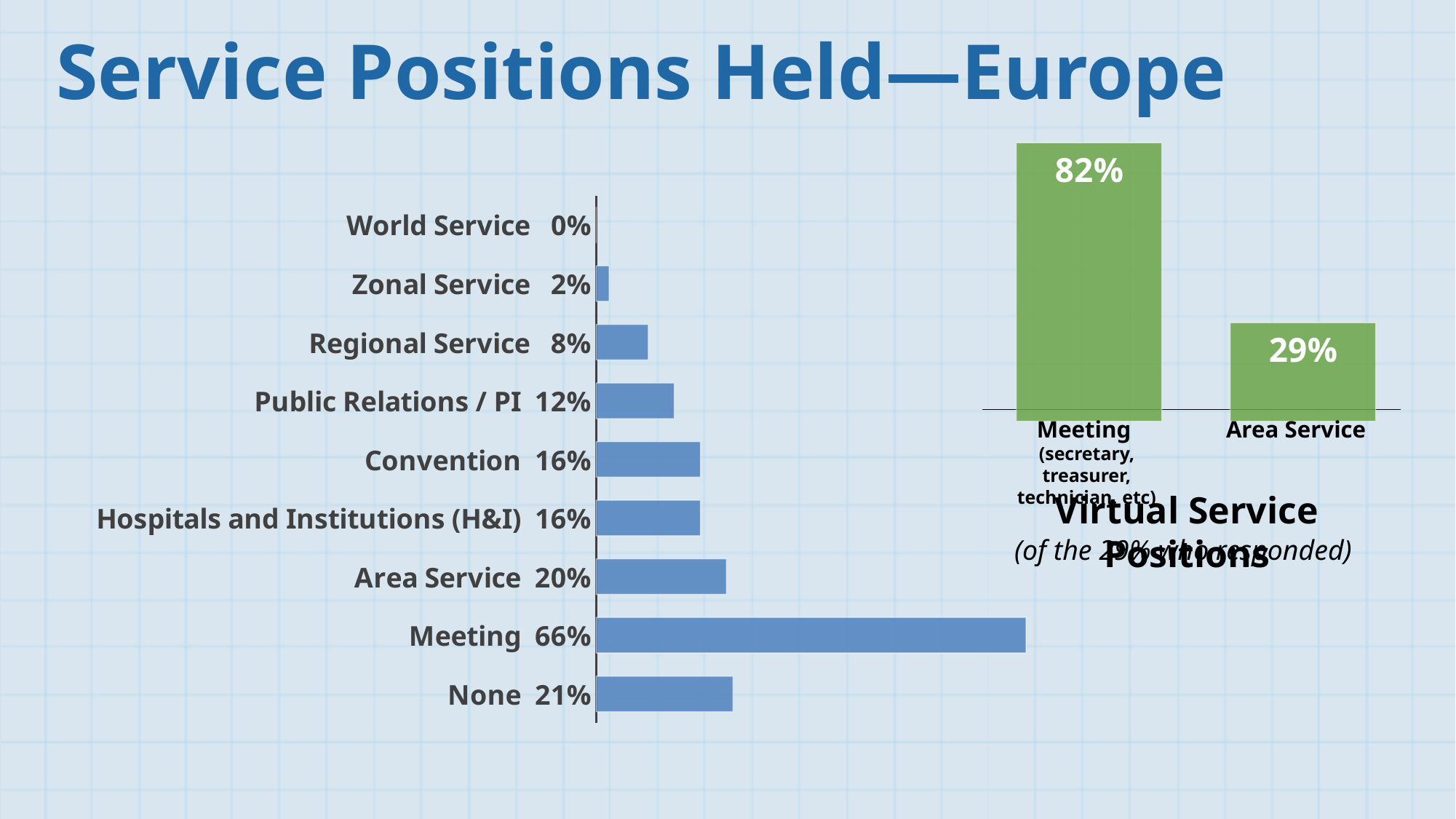
In the Virtual Service Positions chart on the right, what is the difference between the values for Meeting and Area Service? 53% What kind of chart is the chart on the left of the slide? Bar chart How many categories does the left bar chart show? 9 How many categories does the Virtual Service Positions chart on the right show? 2 In the left bar chart, what is the value for Meeting? 66% In the left bar chart, which category has the lowest value? World Service In the left bar chart, what is the value for Public Relations / PI? 12% In the left bar chart, which is larger, the value for Regional Service or the value for Zonal Service? Regional Service In the left bar chart, which category has the highest value? Meeting In the Virtual Service Positions chart on the right, what is the value for Meeting? 82% In the left bar chart, what is the difference between the values for Meeting and None? 45% In the left bar chart, what is the value for Area Service? 20%